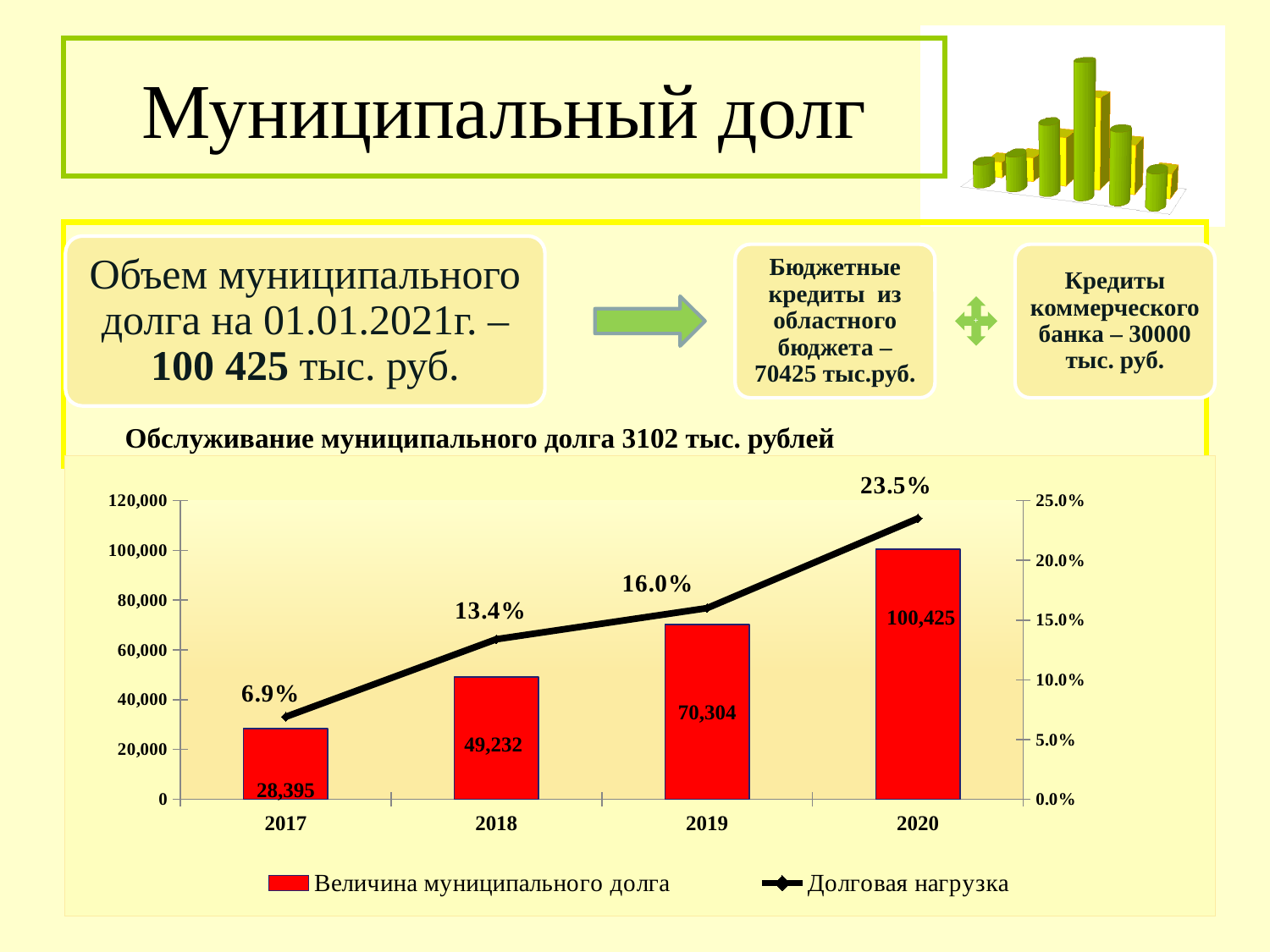
Which year has the highest Величина муниципального долга? 2020 Which is larger, the Величина муниципального долга for 2018 or for 2019? 2019 How many series does the chart legend list? 2 What is the value of Величина муниципального долга for 2017? 28,395 How many years are shown on the x axis of the chart? 4 What colour are the bars for Величина муниципального долга? red Is the Величина муниципального долга for 2018 greater or less than 40,000? greater Does the Долговая нагрузка rise or fall from 2017 to 2020? rise Which year has the lowest Долговая нагрузка? 2017 What is the value of Величина муниципального долга for 2019? 70,304 What is the difference between the Величина муниципального долга values for 2020 and 2019? 30,121 What is the Долговая нагрузка value for 2018? 13.4%